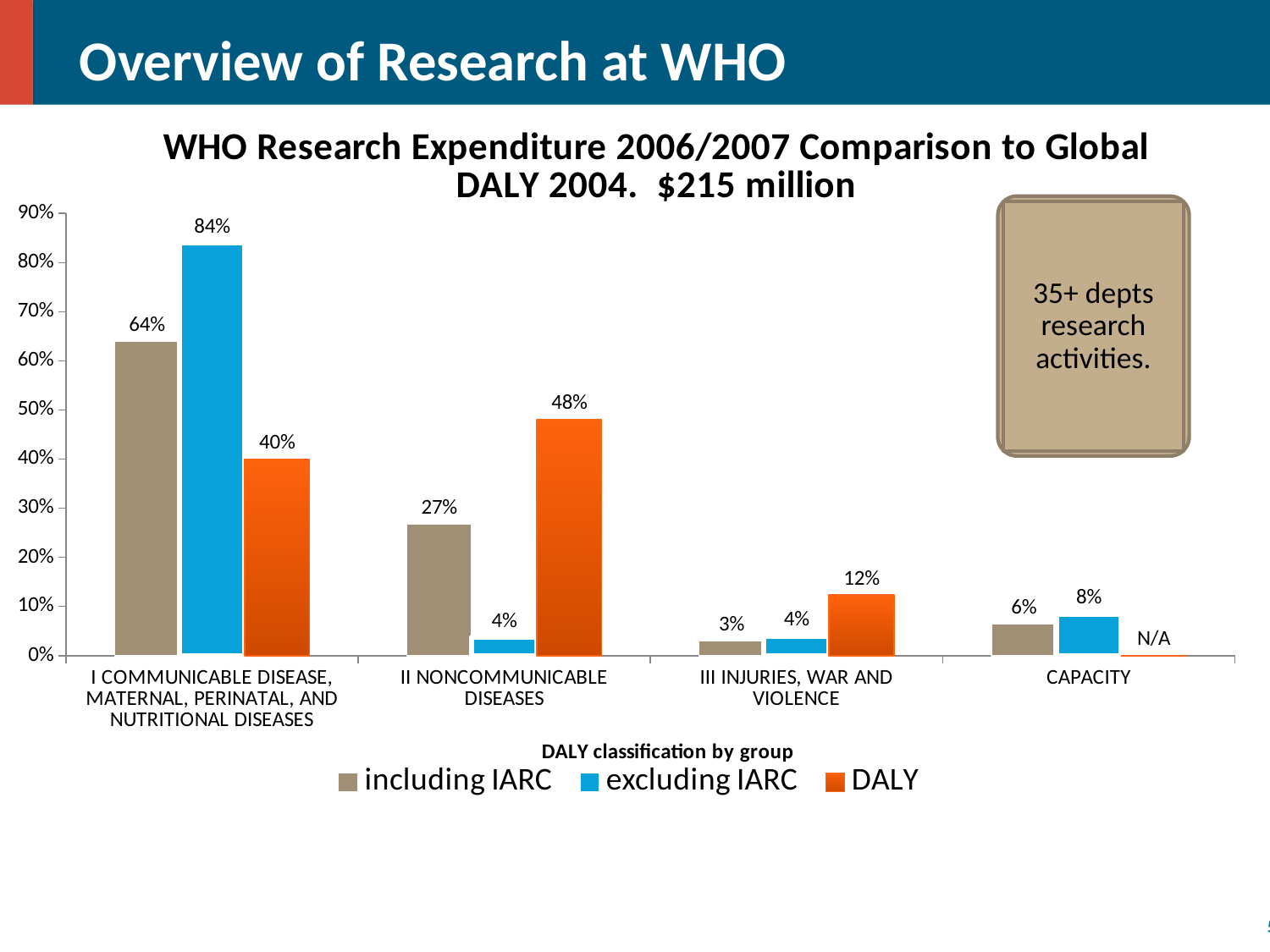
Which category has the highest 'including IARC' value? I Communicable Disease, Maternal, Perinatal, and Nutritional Diseases How many series does the legend list? 3 What type of chart is shown on the slide? Bar chart How many categories are shown on the x axis? 4 What is shown as the DALY value for Capacity? N/A For II Noncommunicable Diseases, which is larger: the 'including IARC' value or the DALY value? DALY What is the 'including IARC' value for III Injuries, War and Violence? 3% What is the x-axis title of the chart? DALY classification by group Which category has the lowest 'excluding IARC' value? II Noncommunicable Diseases and III Injuries, War and Violence (both 4%) What is the 'excluding IARC' value for I Communicable Disease, Maternal, Perinatal, and Nutritional Diseases? 84% What is the difference between the 'excluding IARC' and DALY values for I Communicable Disease, Maternal, Perinatal, and Nutritional Diseases? 44% What is the DALY value for II Noncommunicable Diseases? 48%